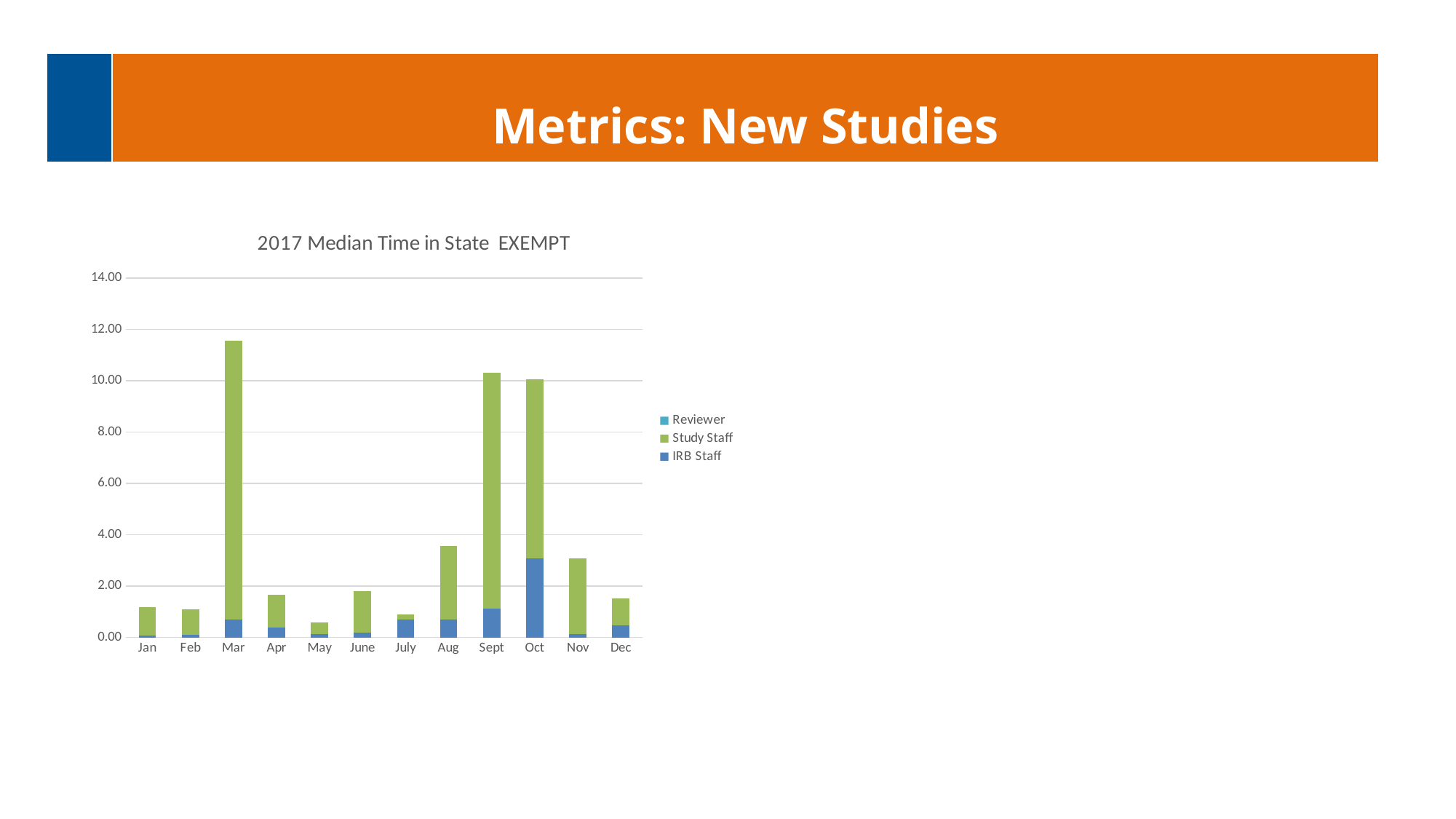
Is the total bar for Sept greater or less than 8.00? greater Which month has the tallest stacked bar? Mar Which month has the shortest stacked bar? May Is the total bar for Mar greater or less than 10.00? greater What type of chart is shown on the slide? Stacked bar chart What is the title of the chart? 2017 Median Time in State EXEMPT Which series is shown in green in the legend? Study Staff How many months are shown on the x axis? 12 Is the total bar for Nov greater or less than 2.00? greater How many series does the legend list? 3 Which has the taller stacked bar, Mar or Sept? Mar